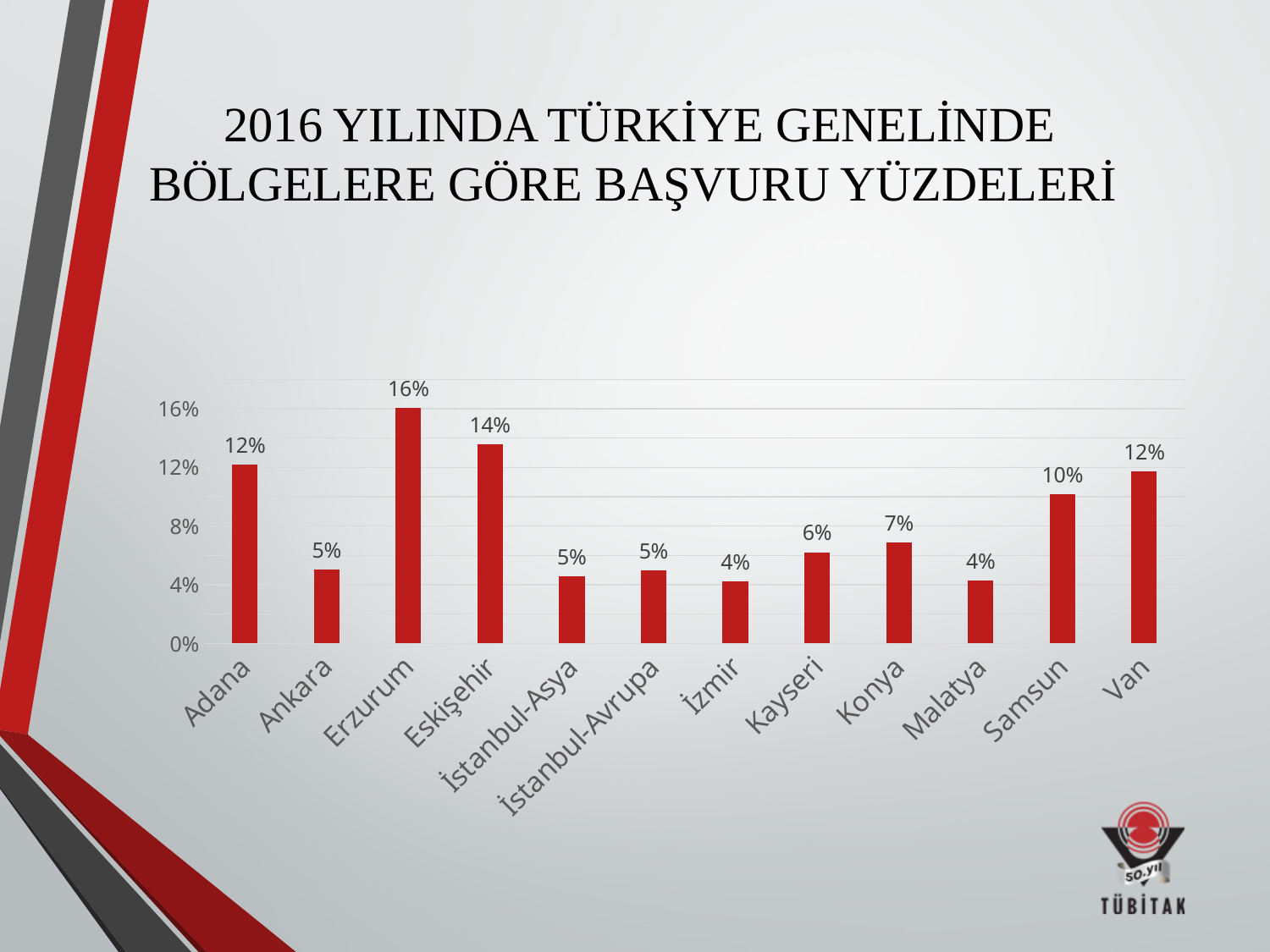
How many categories are shown on the x axis? 12 What kind of chart is shown on the slide? bar chart Which is larger, the value for Samsun or the value for Konya? Samsun What is the difference between the values for Adana and Ankara? 7% What is the title of the slide? 2016 YILINDA TÜRKİYE GENELİNDE BÖLGELERE GÖRE BAŞVURU YÜZDELERİ What is the value for Eskişehir? 14% What is the value for Erzurum? 16% Is the value for Samsun greater or less than 8%? greater Which category has the highest value? Erzurum What is the value for Konya? 7% What is the difference between the values for Erzurum and Eskişehir? 2% What is the value for Samsun? 10%